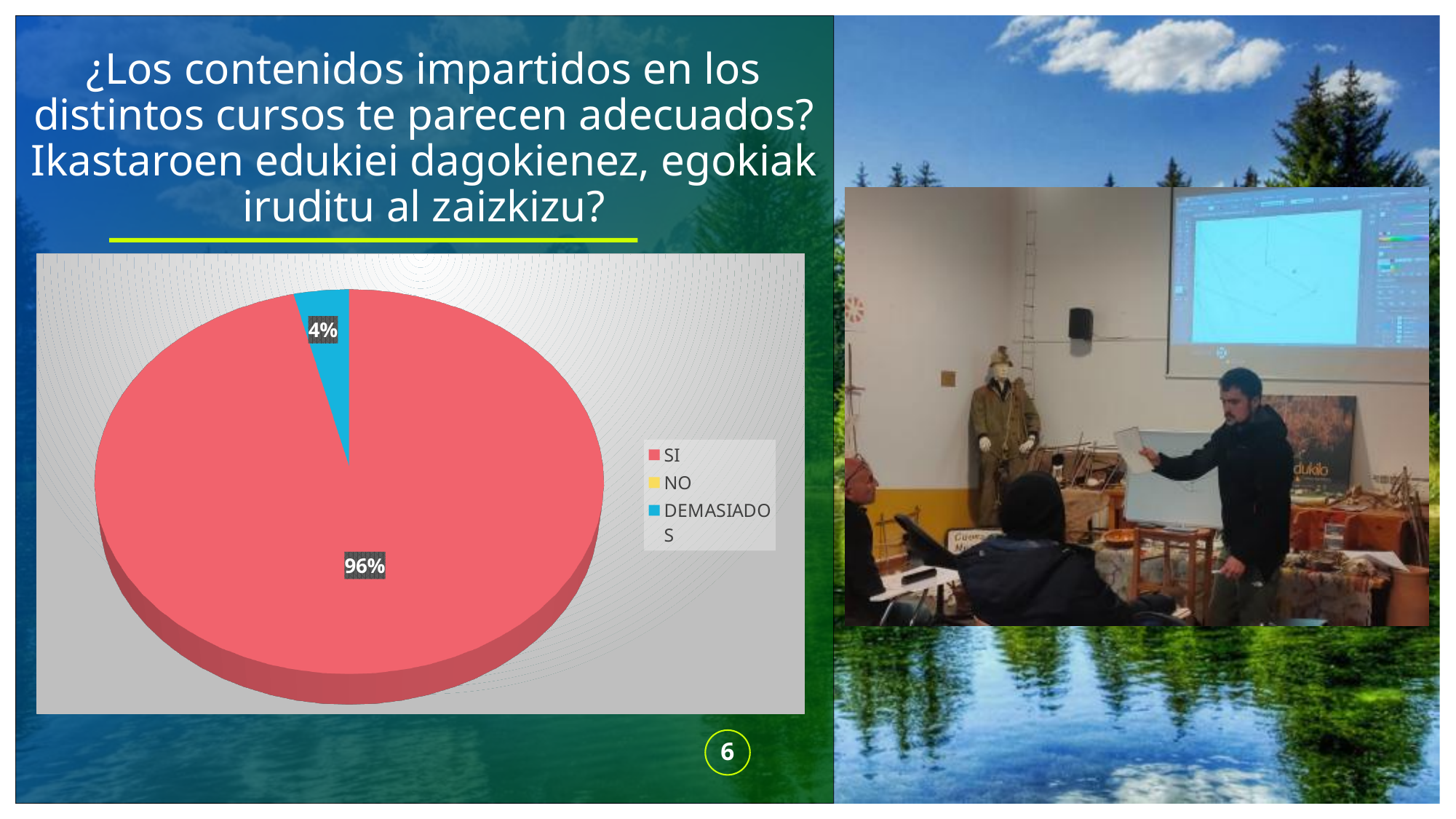
How many entries does the chart legend list? 3 Is the share for SI greater or less than 50%? greater What is the difference between the SI share and the DEMASIADOS share? 92 percentage points Which of the two labelled slices is larger, SI or DEMASIADOS? SI What share of the pie does the SI slice represent? 96% Which legend entry is shown in blue? DEMASIADOS How many slices have a percentage label printed on the pie? 2 What share of the pie does the DEMASIADOS slice represent? 4% What colour is the SI slice in the pie chart? Red What kind of chart is shown on the slide? Pie chart Which category has the largest slice of the pie? SI